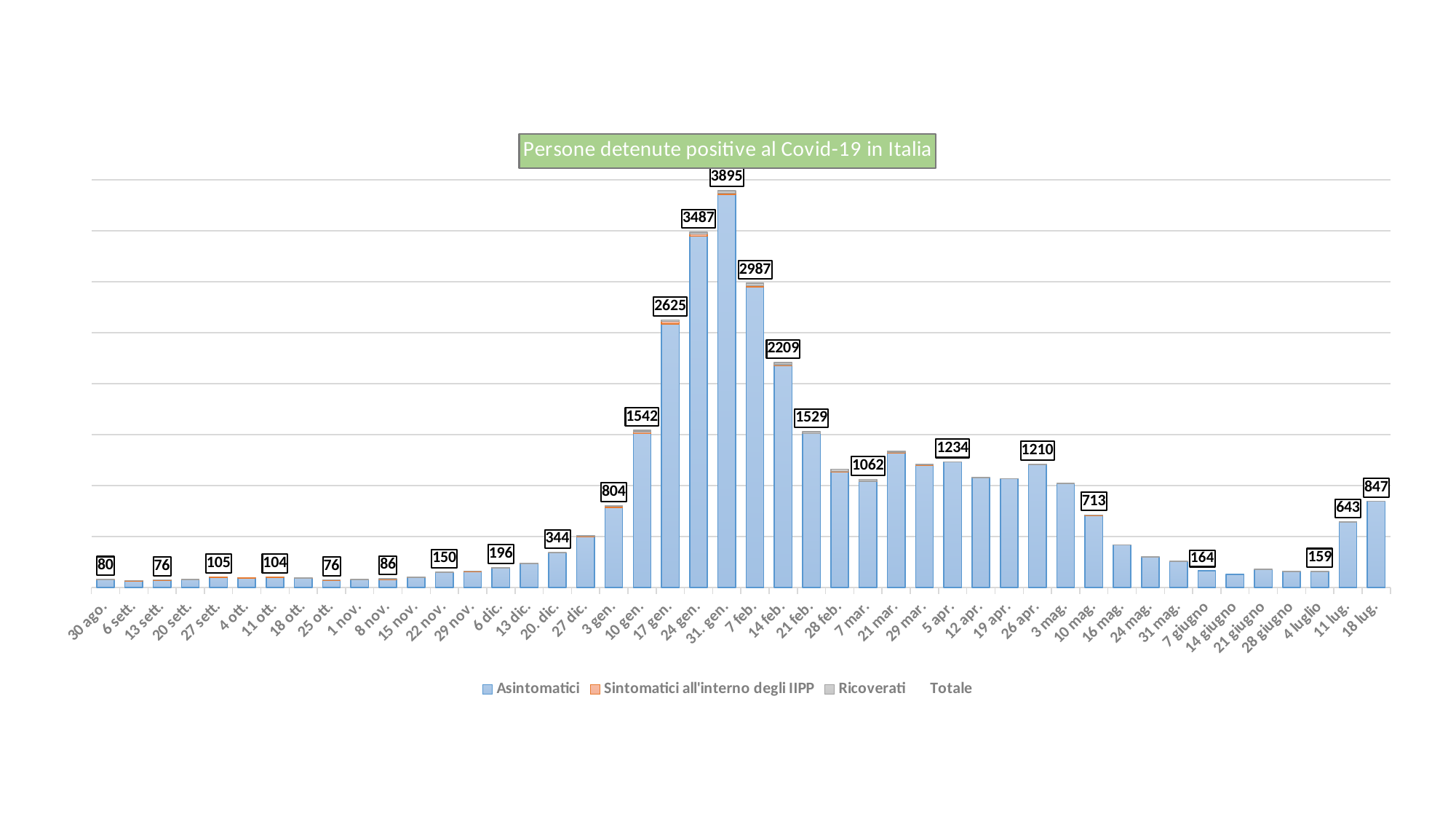
Do the totals rise or fall from 10 gen. to 31 gen.? rise What is the difference between the totals for 18 lug. and 11 lug.? 204 What is the difference between the totals for 31 gen. and 24 gen.? 408 What kind of chart is shown? stacked bar chart What is the total value labelled for 18 lug.? 847 Which is larger, the total for 17 gen. or the total for 7 feb.? 7 feb. What is the total value labelled for 10 mag.? 713 Which date has the highest total? 31 gen. How many series does the legend list? 4 What is the title of the chart? Persone detenute positive al Covid-19 in Italia What is the total value labelled for 31 gen.? 3895 What is the total value labelled for 20 dic.? 344